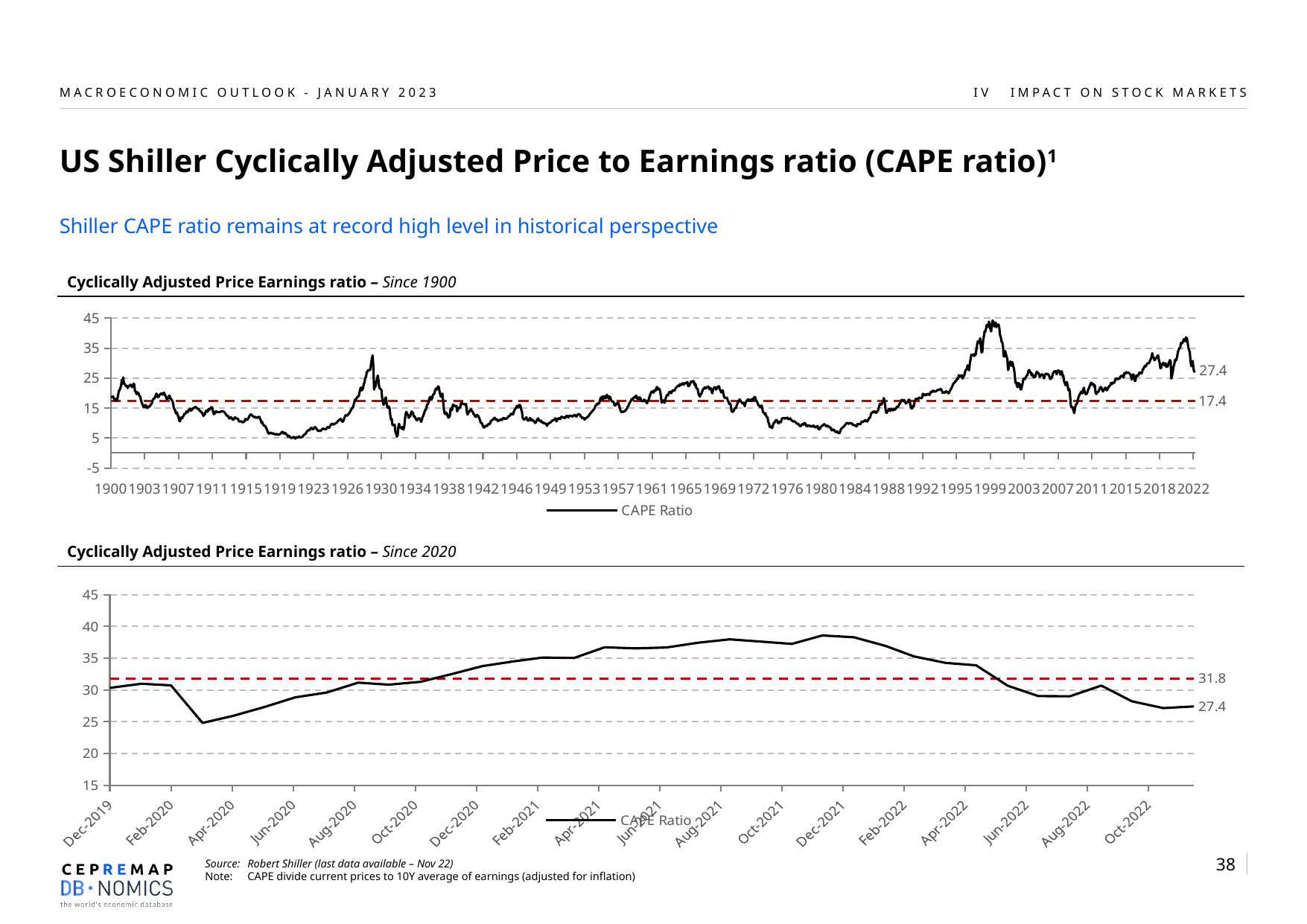
How many series does the legend of the 'Since 2020' chart list? 1 In the 'Since 2020' chart, does the CAPE Ratio rise or fall between Dec-2021 and Oct-2022? fall In the 'Since 1900' chart, what value is labelled on the red dashed horizontal line? 17.4 In the 'Since 2020' chart, what is the difference between the dashed line value (31.8) and the latest CAPE Ratio value (27.4)? 4.4 In the 'Since 1900' chart, what is the latest value of the CAPE Ratio labelled at the right end of the line? 27.4 What kind of chart is the 'Cyclically Adjusted Price Earnings ratio – Since 1900' chart? line chart In the 'Since 1900' chart, what is the difference between the latest CAPE Ratio value (27.4) and the dashed line value (17.4)? 10.0 In the 'Since 2020' chart, what value is labelled on the red dashed horizontal line? 31.8 In the 'Since 2020' chart, is the CAPE Ratio in Apr-2020 greater or less than 30? less In the 'Since 1900' chart, is the CAPE Ratio around 1920 greater or less than 15? less In the 'Since 2020' chart, what is the latest value of the CAPE Ratio labelled at the right end of the line? 27.4 In the 'Since 1900' chart, is the peak of the CAPE Ratio around 1999–2000 greater or less than 35? greater